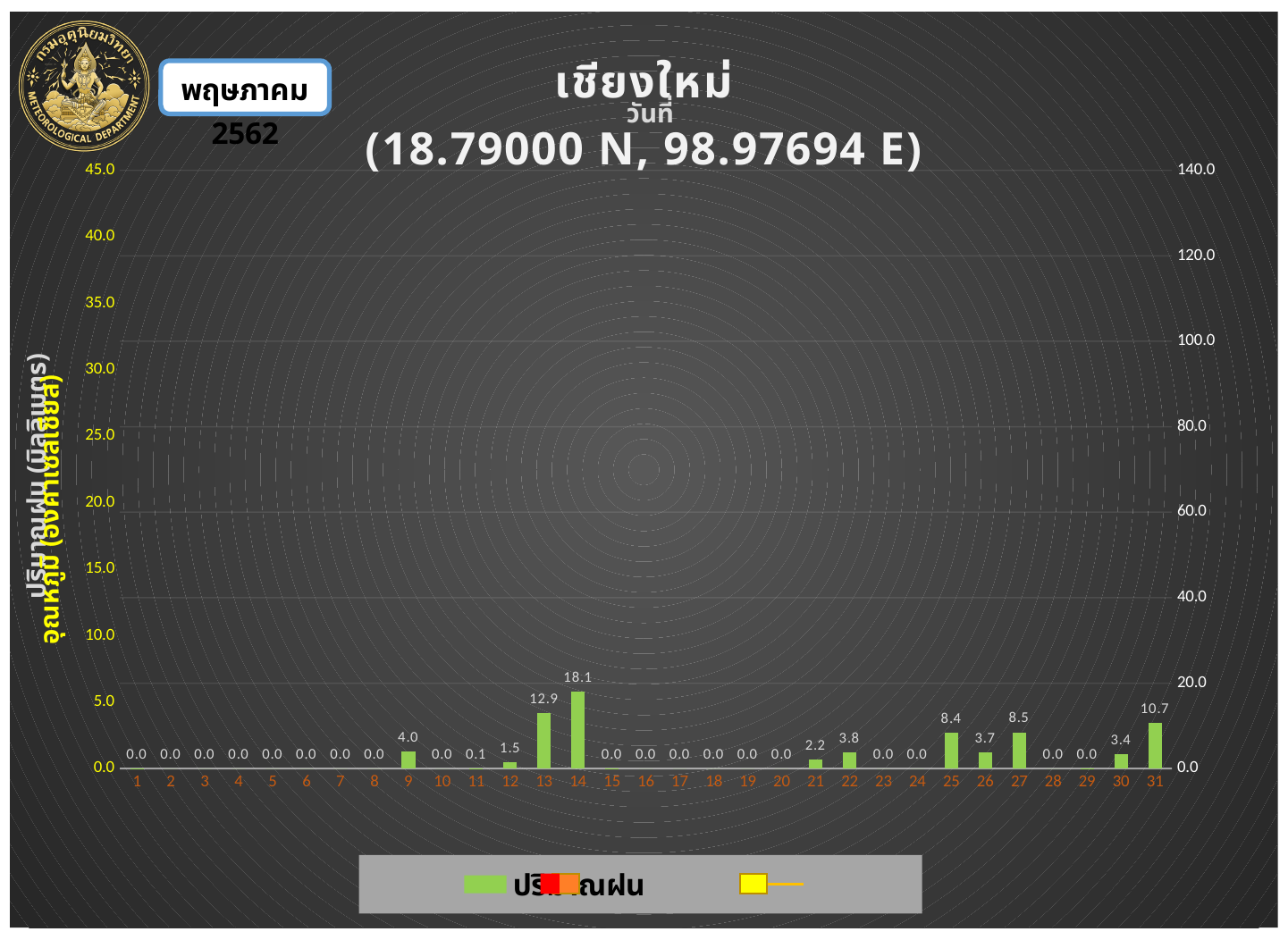
What is the difference between the rainfall values for day 14 and day 13? 5.2 Which day has the highest rainfall value? 14 What is the rainfall value shown for day 9? 4.0 What is the rainfall value shown for day 25? 8.4 Which is larger, the rainfall value for day 31 or for day 25? day 31 Which is larger, the rainfall value for day 22 or for day 21? day 22 What is the difference between the rainfall values for day 27 and day 26? 4.8 How many days are shown on the x axis? 31 What is the rainfall value shown for day 14? 18.1 What is the rainfall value shown for day 31? 10.7 What colour are the rainfall bars? green What kind of chart is used to show the rainfall values? bar chart